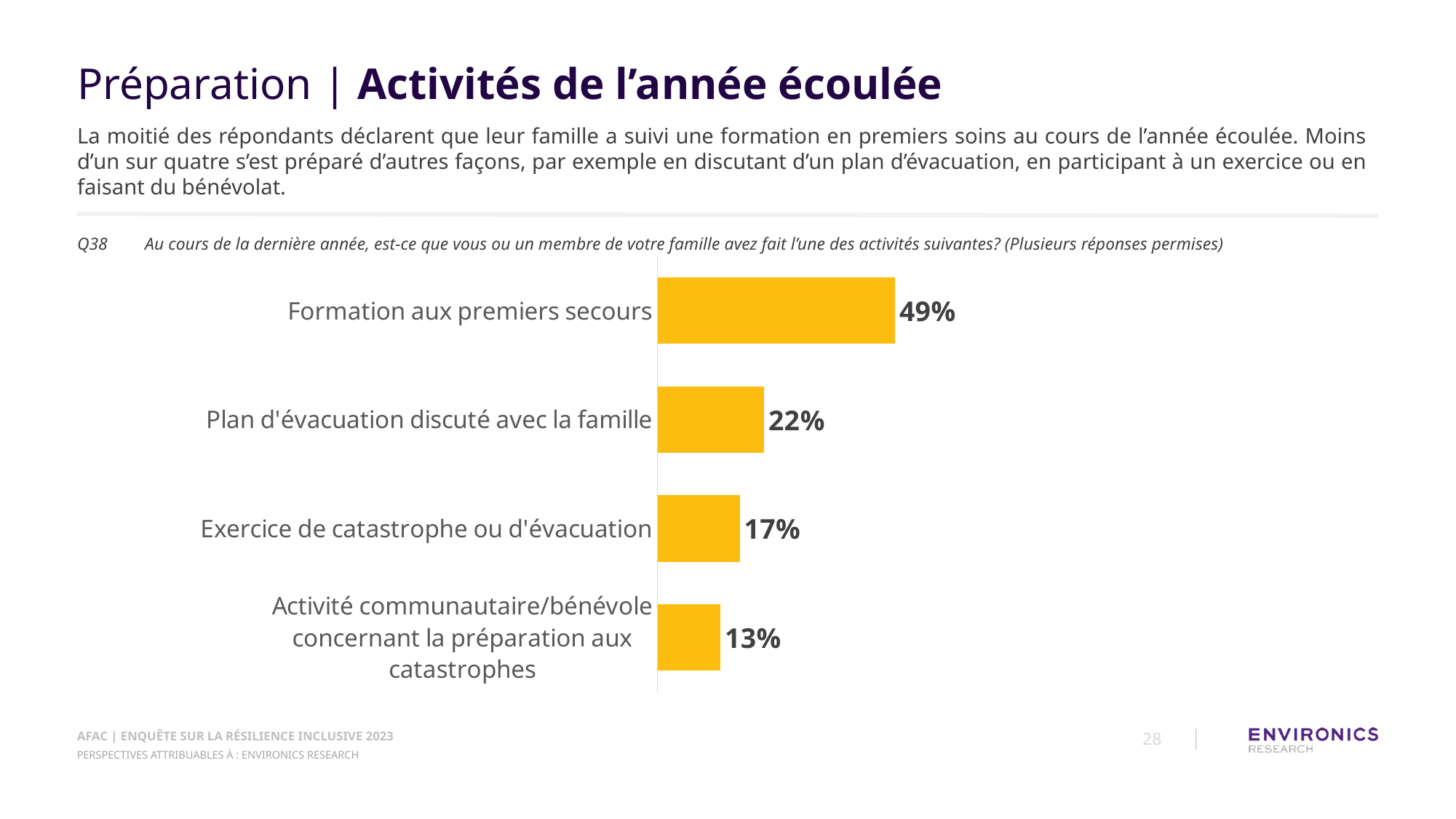
What type of chart is shown on the slide? Bar chart What is the value shown for 'Plan d'évacuation discuté avec la famille'? 22% How many activities are shown in the chart? 4 What is the difference in percentage points between 'Exercice de catastrophe ou d'évacuation' and 'Activité communautaire/bénévole concernant la préparation aux catastrophes'? 4 What is the difference in percentage points between 'Formation aux premiers secours' and 'Plan d'évacuation discuté avec la famille'? 27 Which activity has the highest percentage? Formation aux premiers secours What percentage of respondents reported 'Formation aux premiers secours'? 49% Which activity has the lowest percentage? Activité communautaire/bénévole concernant la préparation aux catastrophes What percentage is shown for 'Activité communautaire/bénévole concernant la préparation aux catastrophes'? 13% What colour are the bars in the chart? Yellow Which is larger: the value for 'Plan d'évacuation discuté avec la famille' or for 'Exercice de catastrophe ou d'évacuation'? Plan d'évacuation discuté avec la famille What is the value shown for 'Exercice de catastrophe ou d'évacuation'? 17%